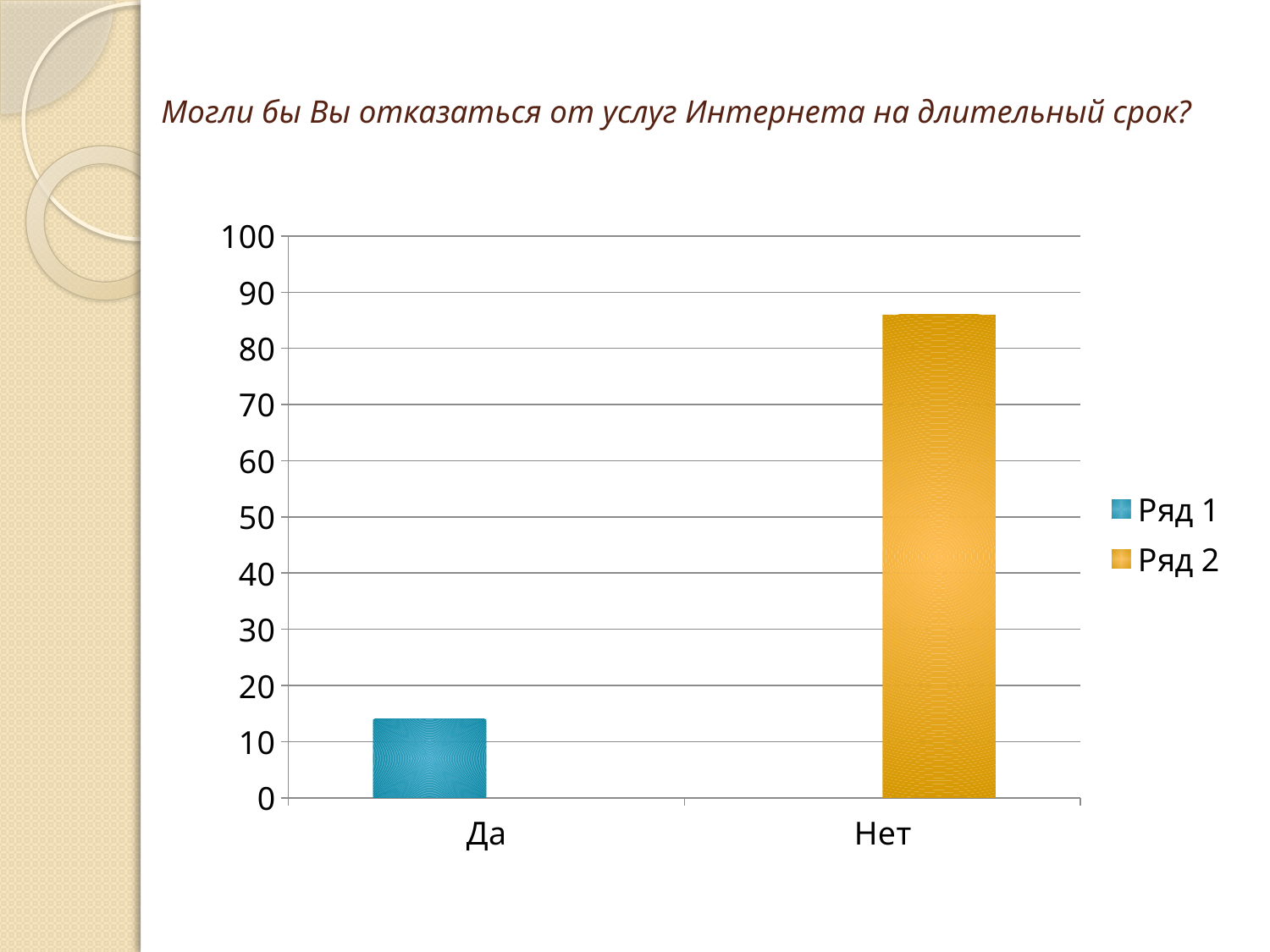
What kind of chart is shown on the slide? bar chart What is the title of the slide above the chart? Могли бы Вы отказаться от услуг Интернета на длительный срок? Is the value for Да greater or less than 10? greater What are the two legend entries of the chart? Ряд 1 and Ряд 2 Is the value for Нет greater or less than 90? less Which bar is taller, Да or Нет? Нет Which category has the highest bar in the chart? Нет Is the value for Да greater or less than 20? less Which category has the lowest bar in the chart? Да How many series does the chart's legend list? 2 How many categories are shown on the x axis of the chart? 2